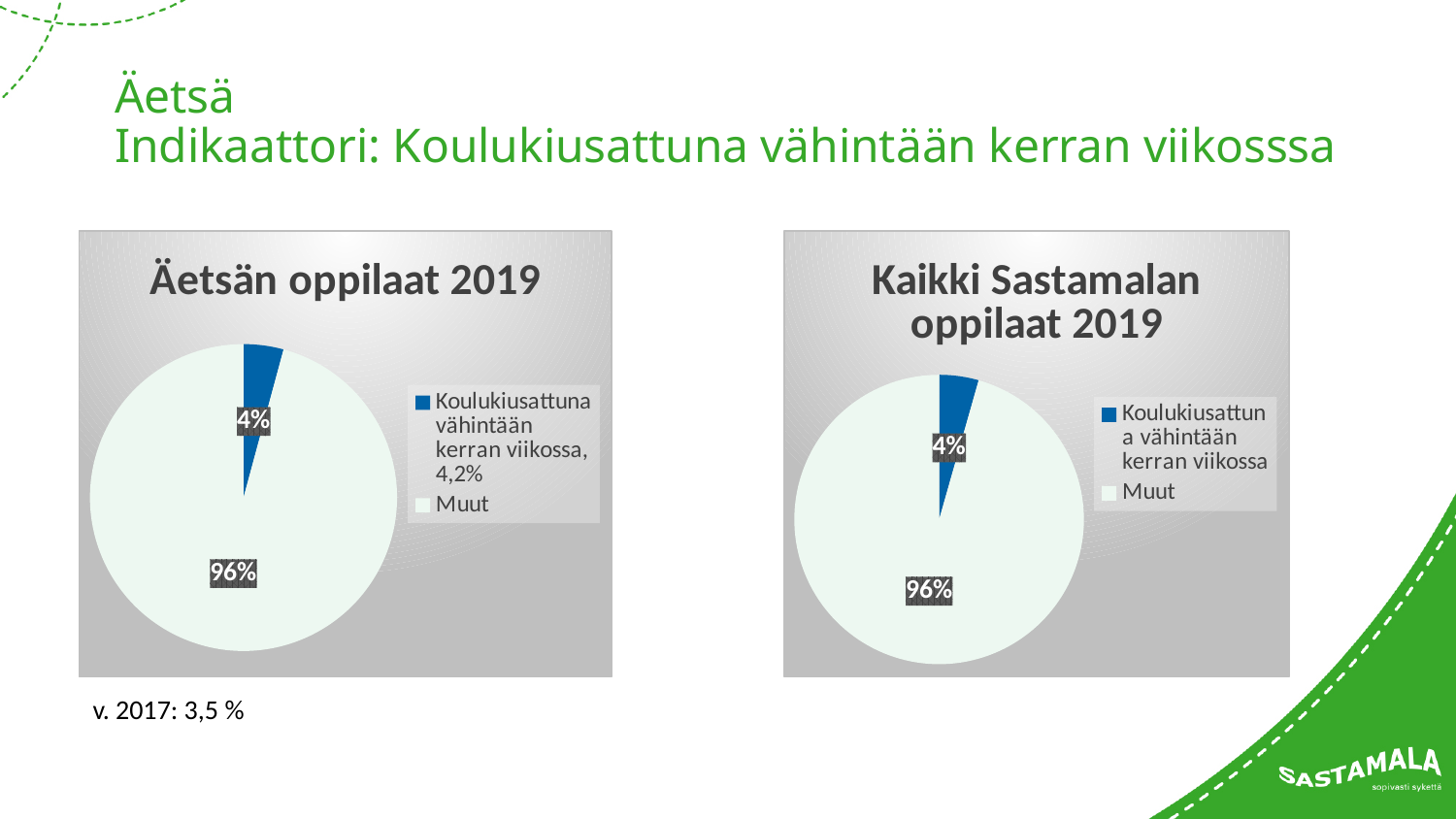
What kind of chart is the chart on the right of the slide? Pie chart What kind of chart is the chart titled "Äetsän oppilaat 2019"? Pie chart In the chart titled "Äetsän oppilaat 2019", what is the difference in percentage points between the "Muut" slice and the "Koulukiusattuna vähintään kerran viikossa" slice? 92 percentage points In the chart titled "Kaikki Sastamalan oppilaat 2019", which slice is the smallest? Koulukiusattuna vähintään kerran viikossa In the chart titled "Kaikki Sastamalan oppilaat 2019", what share of the pie is the slice for "Koulukiusattuna vähintään kerran viikossa"? 4% In the chart titled "Äetsän oppilaat 2019", what colour is the slice for "Koulukiusattuna vähintään kerran viikossa"? Blue In the chart titled "Äetsän oppilaat 2019", which slice is the largest? Muut In the chart titled "Äetsän oppilaat 2019", what share of the pie is the slice for "Koulukiusattuna vähintään kerran viikossa"? 4% How many slices does the pie chart titled "Äetsän oppilaat 2019" have? 2 How many entries does the legend of the chart titled "Kaikki Sastamalan oppilaat 2019" list? 2 In the chart titled "Kaikki Sastamalan oppilaat 2019", what share of the pie is labelled "Muut"? 96%